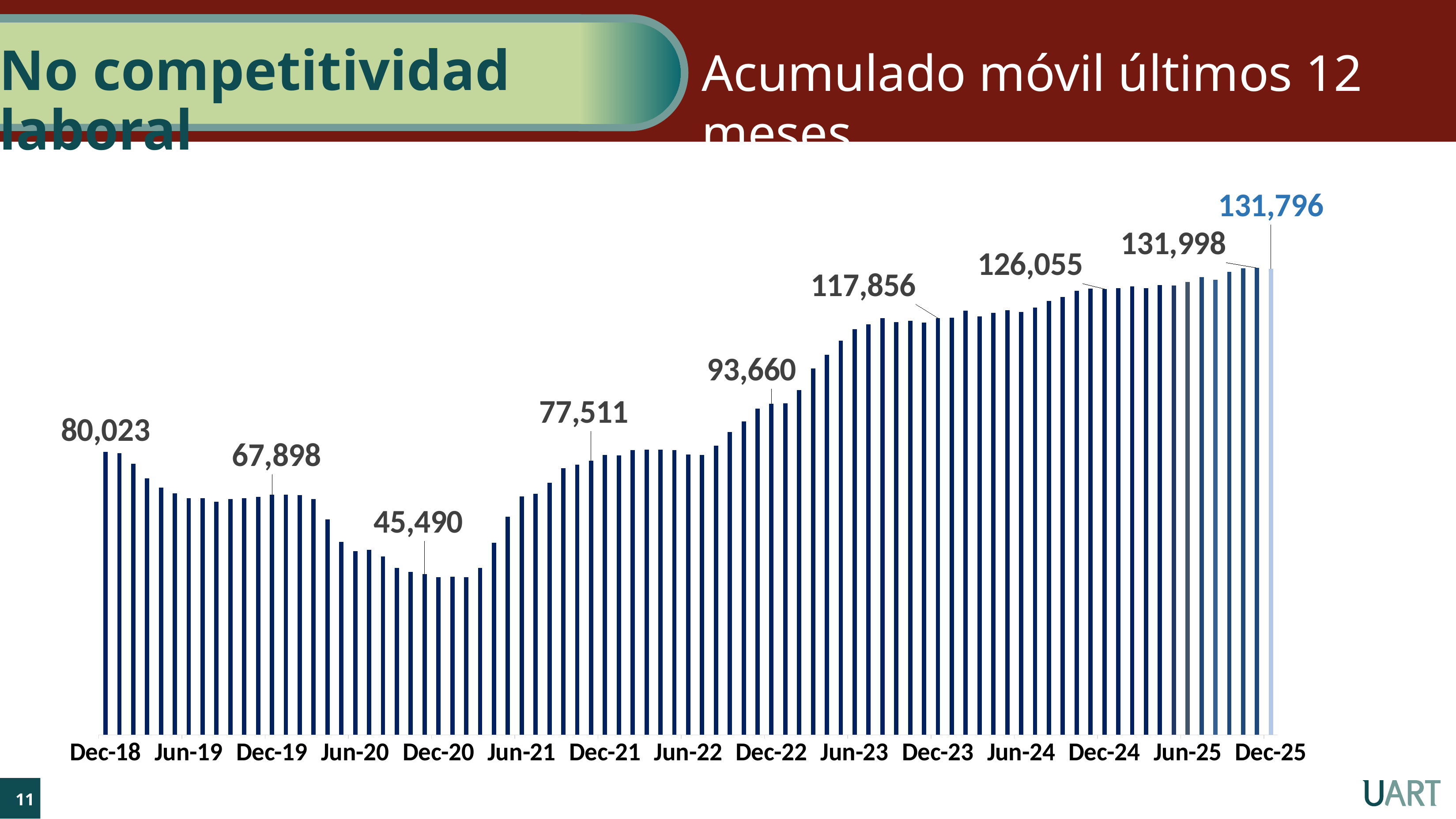
What is the difference between the Dec-23 value and the Dec-22 value? 24,196 What kind of chart is shown on the slide? bar chart What is the value shown for Dec-22? 93,660 What is the title shown in the header next to the chart? Acumulado móvil últimos 12 meses Which is larger, the value for Dec-19 or the value for Dec-21? Dec-21 What is the value shown for Dec-18? 80,023 Do the values rise or fall from Dec-20 to Dec-23? rise What is the difference between the Dec-24 value and the Dec-23 value? 8,199 What is the value shown for Dec-25, the last bar? 131,796